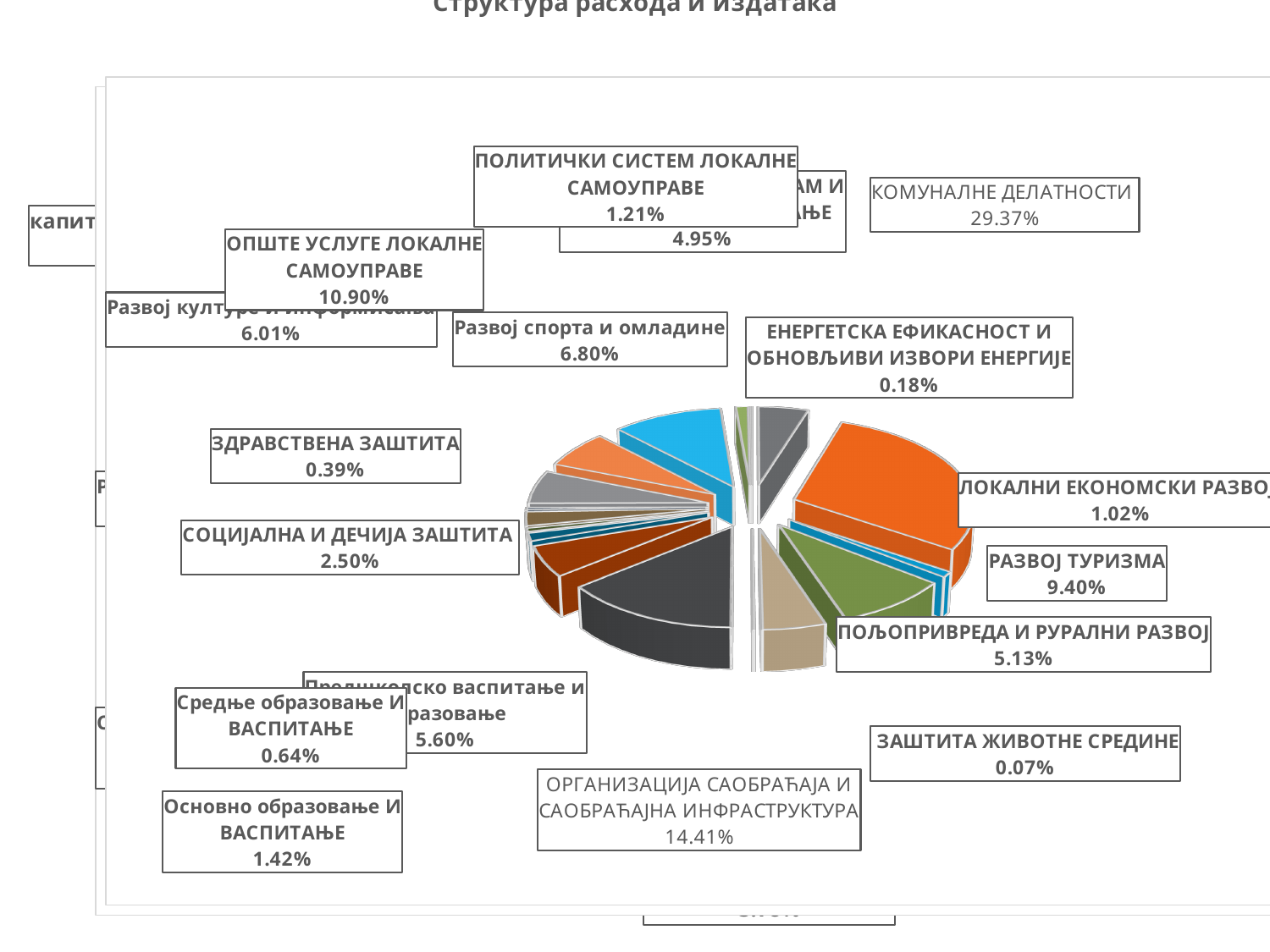
Which is larger, Развој културе и информисања or Предшколско васпитање и образовање? Развој културе и информисања What is the value for ОПШТЕ УСЛУГЕ ЛОКАЛНЕ САМОУПРАВЕ? 10.90% What share of the pie does ЗАШТИТА ЖИВОТНЕ СРЕДИНЕ represent? 0.07% Which is larger, СОЦИЈАЛНА И ДЕЧИЈА ЗАШТИТА or ЗДРАВСТВЕНА ЗАШТИТА? СОЦИЈАЛНА И ДЕЧИЈА ЗАШТИТА What share of the pie does КОМУНАЛНЕ ДЕЛАТНОСТИ represent? 29.37% What is the difference between Основно образовање И ВАСПИТАЊЕ and Средње образовање И ВАСПИТАЊЕ? 0.78% What is the value for Развој спорта и омладине? 6.80% What is the value for ОРГАНИЗАЦИЈА САОБРАЋАЈА И САОБРАЋАЈНА ИНФРАСТРУКТУРА? 14.41% What is the value for ПОЉОПРИВРЕДА И РУРАЛНИ РАЗВОЈ? 5.13% What is the value for РАЗВОЈ ТУРИЗМА? 9.40% What is the difference between КОМУНАЛНЕ ДЕЛАТНОСТИ and ОРГАНИЗАЦИЈА САОБРАЋАЈА И САОБРАЋАЈНА ИНФРАСТРУКТУРА? 14.96% What type of chart is shown on the slide? pie chart